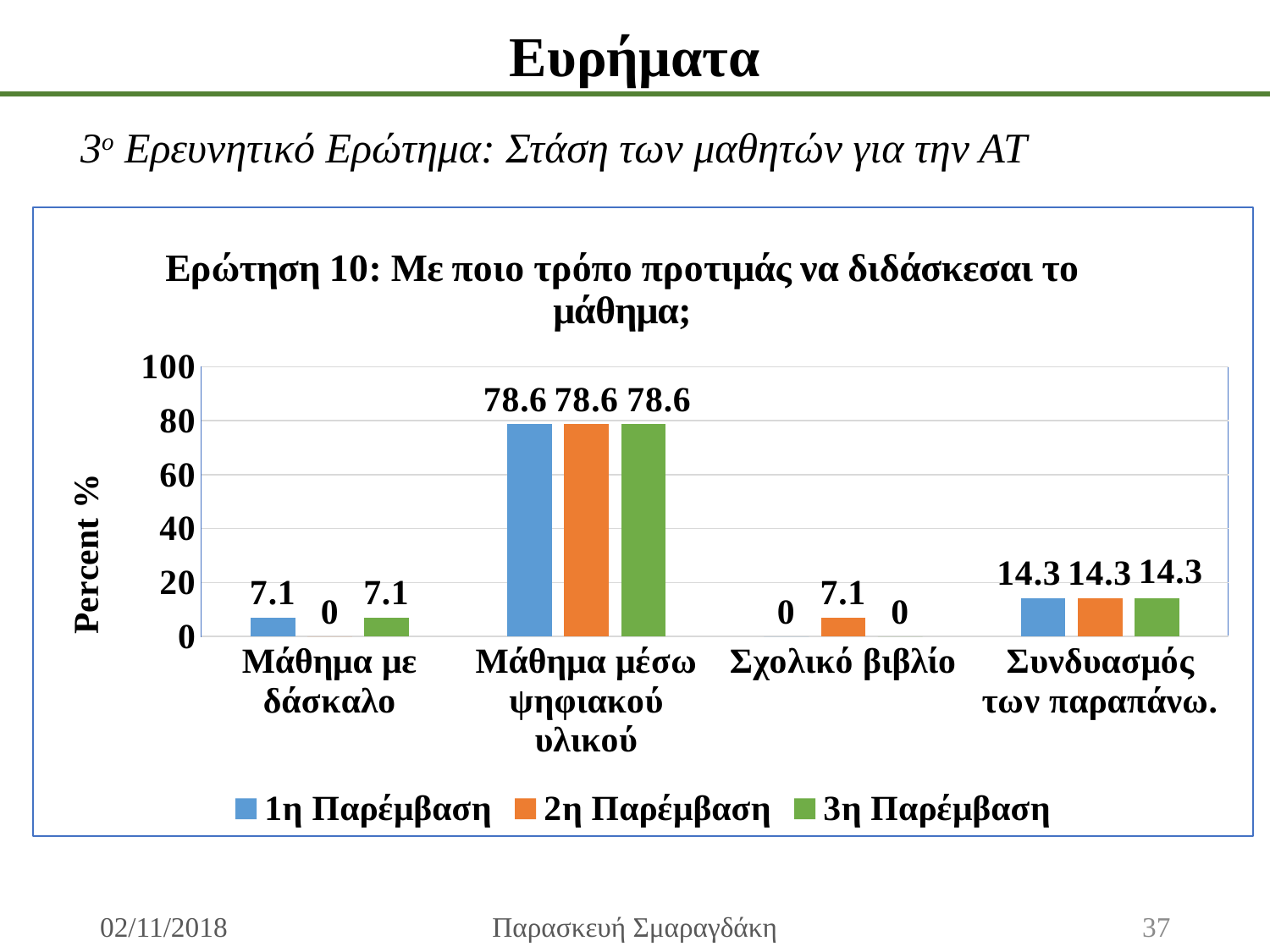
What is the value for 1η Παρέμβαση in the category Συνδυασμός των παραπάνω.? 14.3 What is the difference between the 1η Παρέμβαση values for Μάθημα μέσω ψηφιακού υλικού and Συνδυασμός των παραπάνω.? 64.3 Which category has the highest value for 1η Παρέμβαση? Μάθημα μέσω ψηφιακού υλικού What is the value for 2η Παρέμβαση in the category Σχολικό βιβλίο? 7.1 What is the label of the y axis? Percent % How many series does the legend list? 3 What is the value for 2η Παρέμβαση in the category Μάθημα με δάσκαλο? 0 What is the value for 1η Παρέμβαση in the category Μάθημα με δάσκαλο? 7.1 How many categories are shown on the x axis? 4 What is the value for 3η Παρέμβαση in the category Μάθημα μέσω ψηφιακού υλικού? 78.6 What kind of chart is shown on the slide? Bar chart Which is larger for 3η Παρέμβαση: Μάθημα με δάσκαλο or Συνδυασμός των παραπάνω.? Συνδυασμός των παραπάνω.